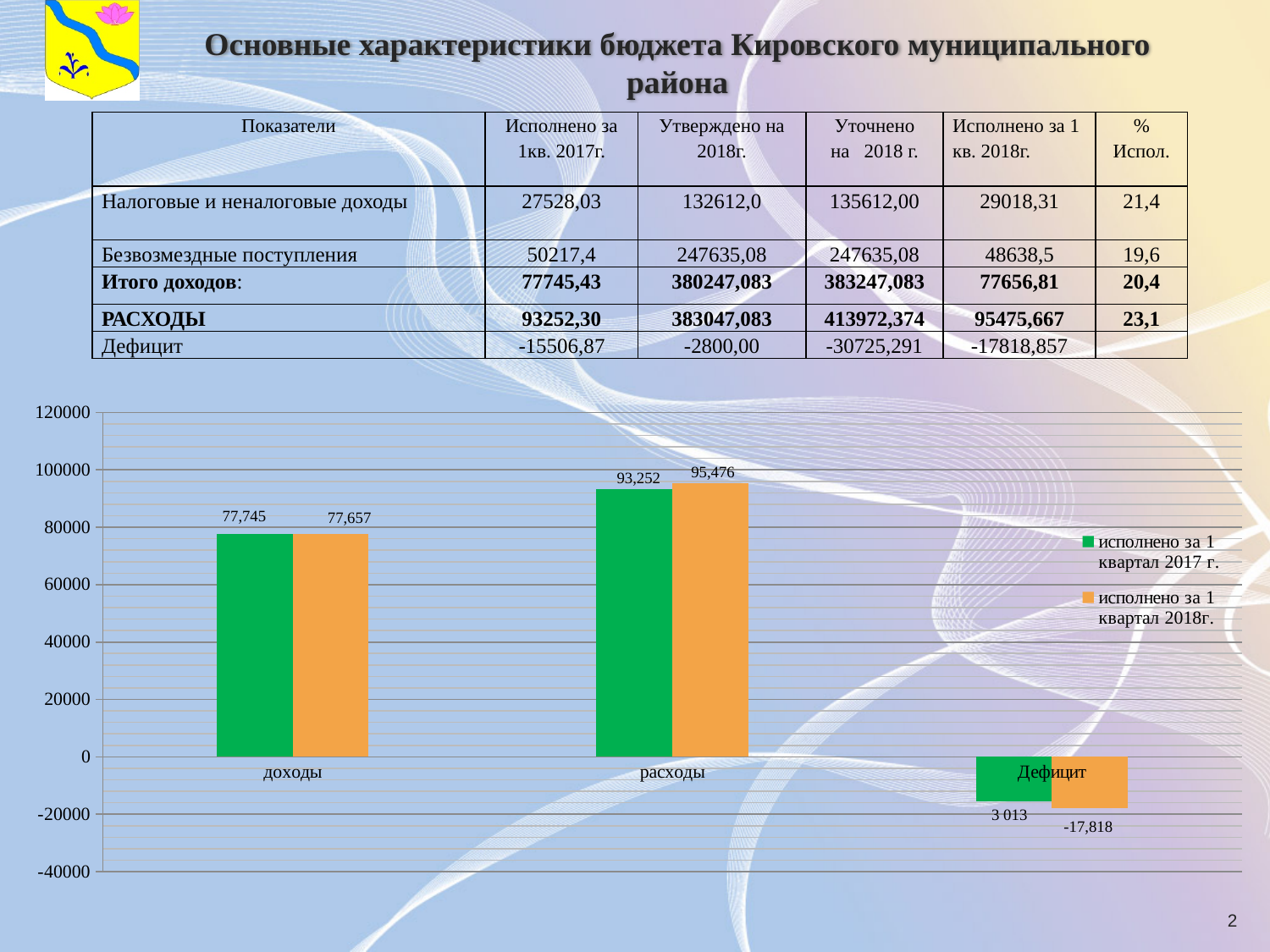
What is the value for расходы in the series 'исполнено за 1 квартал 2018г.'? 95,476 For расходы, which series has the larger value: 'исполнено за 1 квартал 2017 г.' or 'исполнено за 1 квартал 2018г.'? исполнено за 1 квартал 2018г. What is the difference between the доходы values for 2017 (77,745) and 2018 (77,657)? 88 What is the difference between the расходы values for 2018 (95,476) and 2017 (93,252)? 2,224 What is the value for Дефицит in the series 'исполнено за 1 квартал 2018г.'? -17,818 Is the value for доходы in the series 'исполнено за 1 квартал 2018г.' greater or less than 80000? less Which category has the highest value in the series 'исполнено за 1 квартал 2018г.'? расходы What colour represents the series 'исполнено за 1 квартал 2017 г.' in the chart? green How many categories are shown on the x axis of the chart? 3 What kind of chart is shown on the slide? bar chart What is the value for доходы in the series 'исполнено за 1 квартал 2017 г.'? 77,745 How many series does the chart legend list? 2